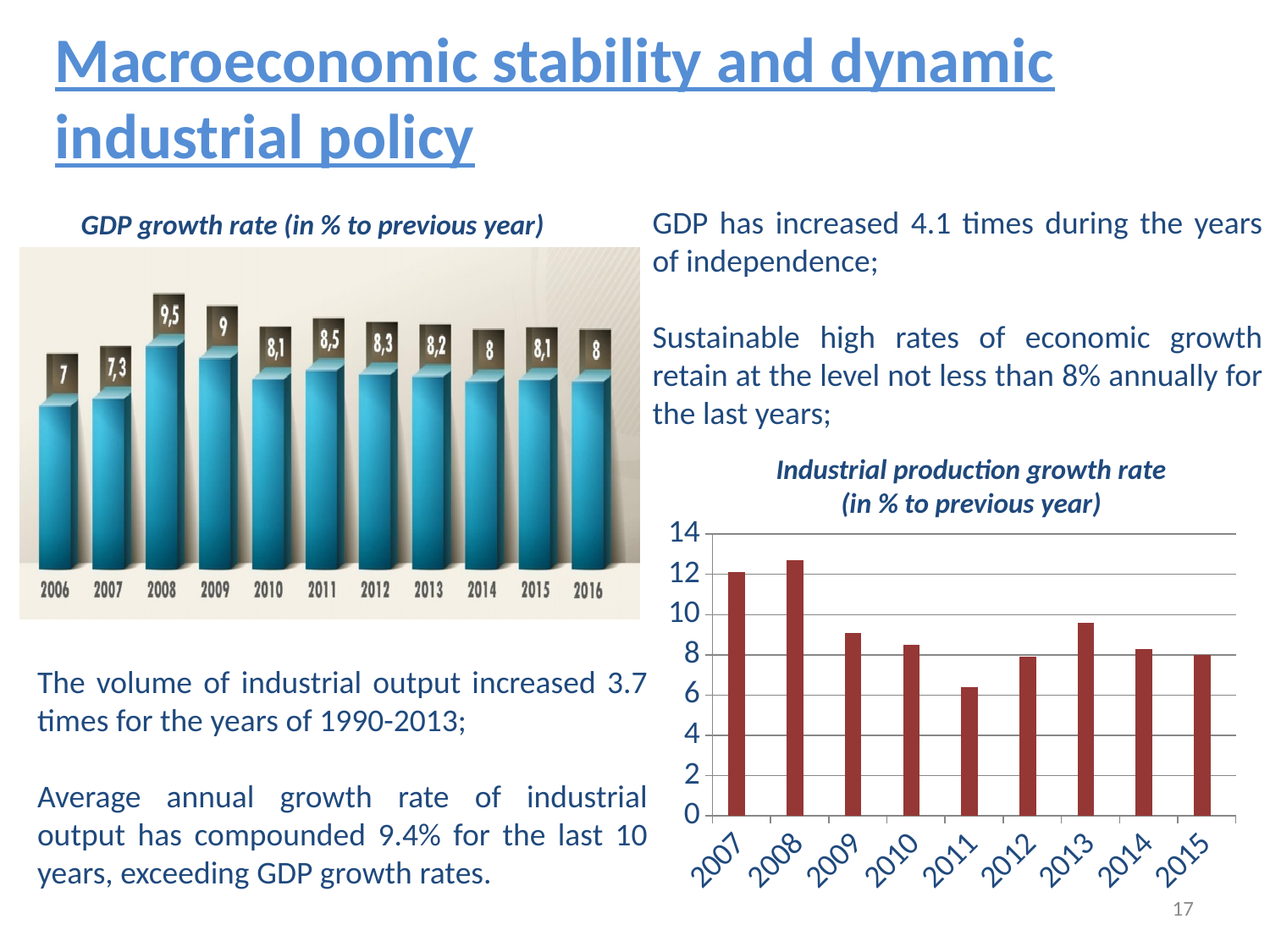
In the GDP growth rate chart, which is larger, the value for 2009 or the value for 2012? 2009 What kind of chart is the Industrial production growth rate chart? bar chart In the Industrial production growth rate chart, which year has the lowest value? 2011 In the GDP growth rate chart, which year has the highest value? 2008 How many years are shown in the GDP growth rate chart? 11 How many years are shown in the Industrial production growth rate chart? 9 In the GDP growth rate chart, what is the value for 2008? 9,5 In the GDP growth rate chart, which year has the lowest value? 2006 In the Industrial production growth rate chart, is the value for 2011 greater or less than 8? less In the Industrial production growth rate chart, is the value for 2008 greater or less than 12? greater In the GDP growth rate chart, what is the difference between the values for 2008 and 2006? 2,5 In the GDP growth rate chart, what is the value for 2011? 8,5